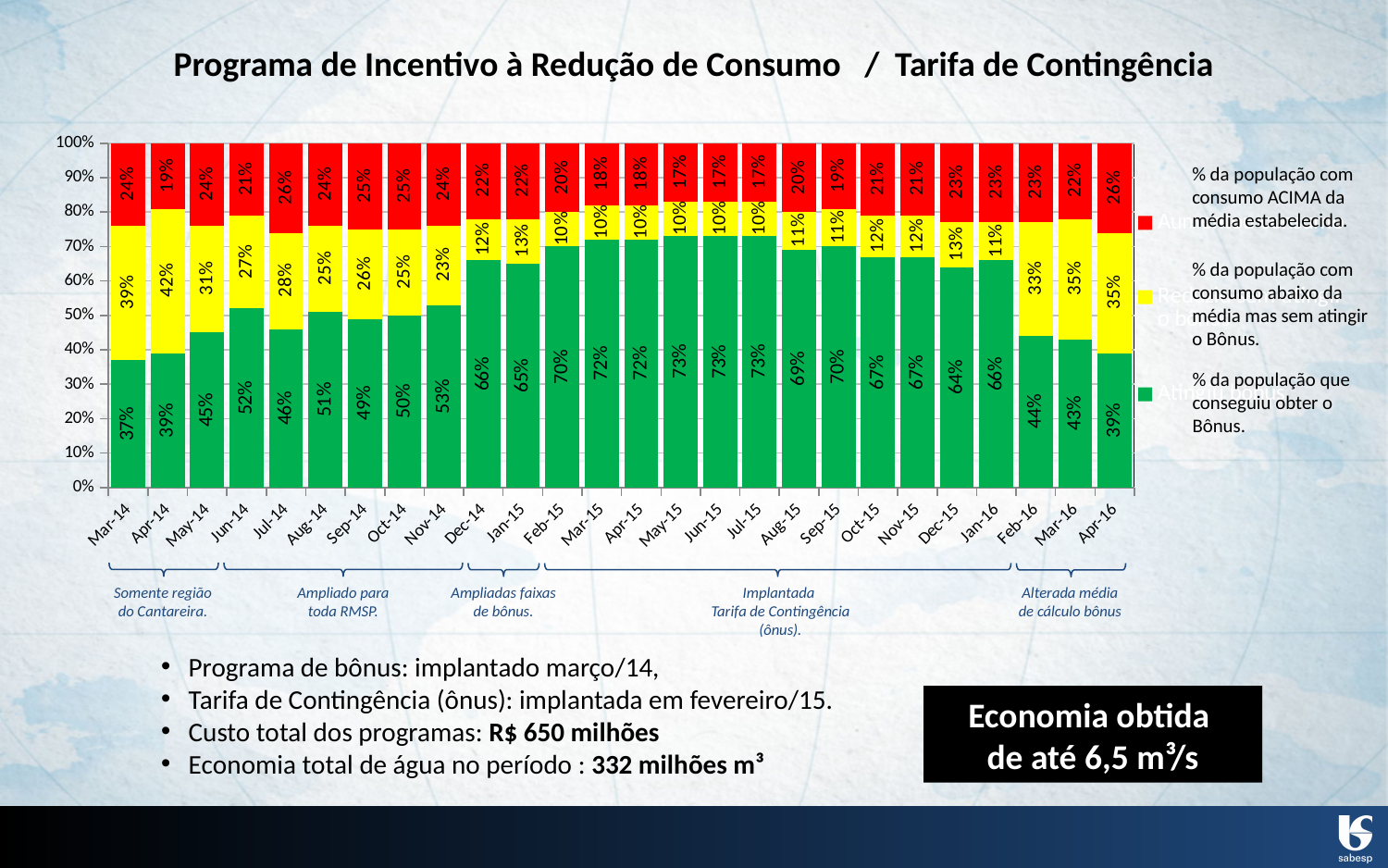
What kind of chart is shown on the slide? Stacked bar chart What is the difference between the green values for Apr-16 and Mar-14? 2 percentage points How many series does the chart's legend list? 3 Is the green value for Jun-15 greater or less than 50%? greater How many months (bars) are plotted on the chart? 26 Which month has the larger green value, Nov-14 or Dec-14? Dec-14 What is the red (consumption above average) value for Apr-16? 26% What is the green (bonus obtained) value for Mar-14? 37% Which month has the lowest green (bonus obtained) value? Mar-14 Which month has the highest yellow (below average but no bonus) value? Apr-14 What is the yellow (below average but no bonus) value for Feb-16? 33% How does the green (bonus obtained) share change from Mar-14 to Jul-15? It rises